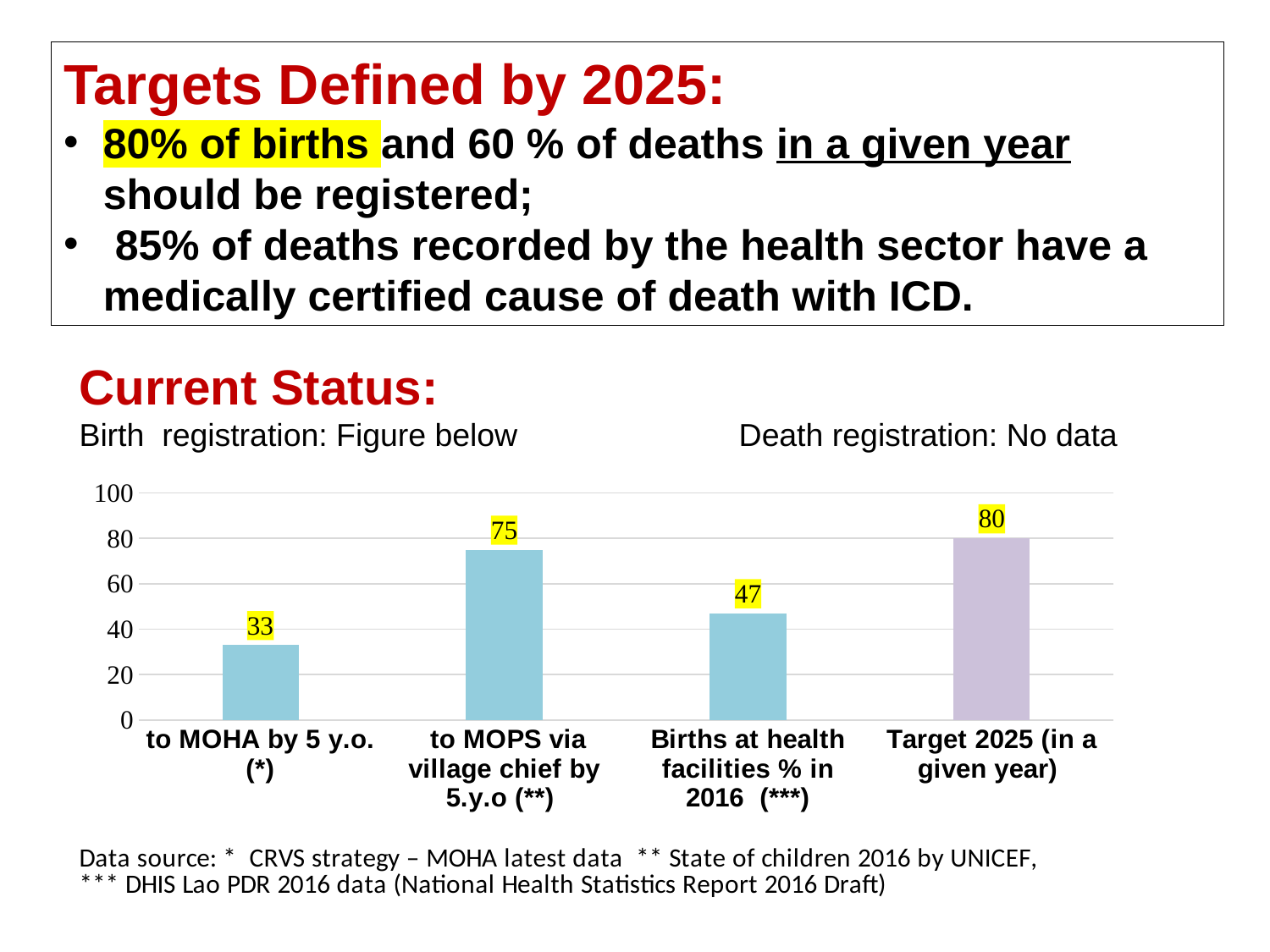
How many categories are shown in the chart? 4 Which is larger: the value for "to MOPS via village chief by 5.y.o (**)" or the value for "Births at health facilities % in 2016 (***)"? to MOPS via village chief by 5.y.o (**) What is the value for "to MOHA by 5 y.o. (*)"? 33 What is the difference between the values for "to MOPS via village chief by 5.y.o (**)" and "Births at health facilities % in 2016 (***)"? 28 Which category has the highest value? Target 2025 (in a given year) What is the difference between the Target 2025 value and the value for "to MOHA by 5 y.o. (*)"? 47 What is the value for "Births at health facilities % in 2016 (***)"? 47 What colour is the bar for "Target 2025 (in a given year)" compared with the other bars? Light purple, while the others are light blue What is the value for "Target 2025 (in a given year)"? 80 What is the value for "to MOPS via village chief by 5.y.o (**)"? 75 Which category has the lowest value? to MOHA by 5 y.o. (*) What kind of chart is shown on the slide? Bar chart